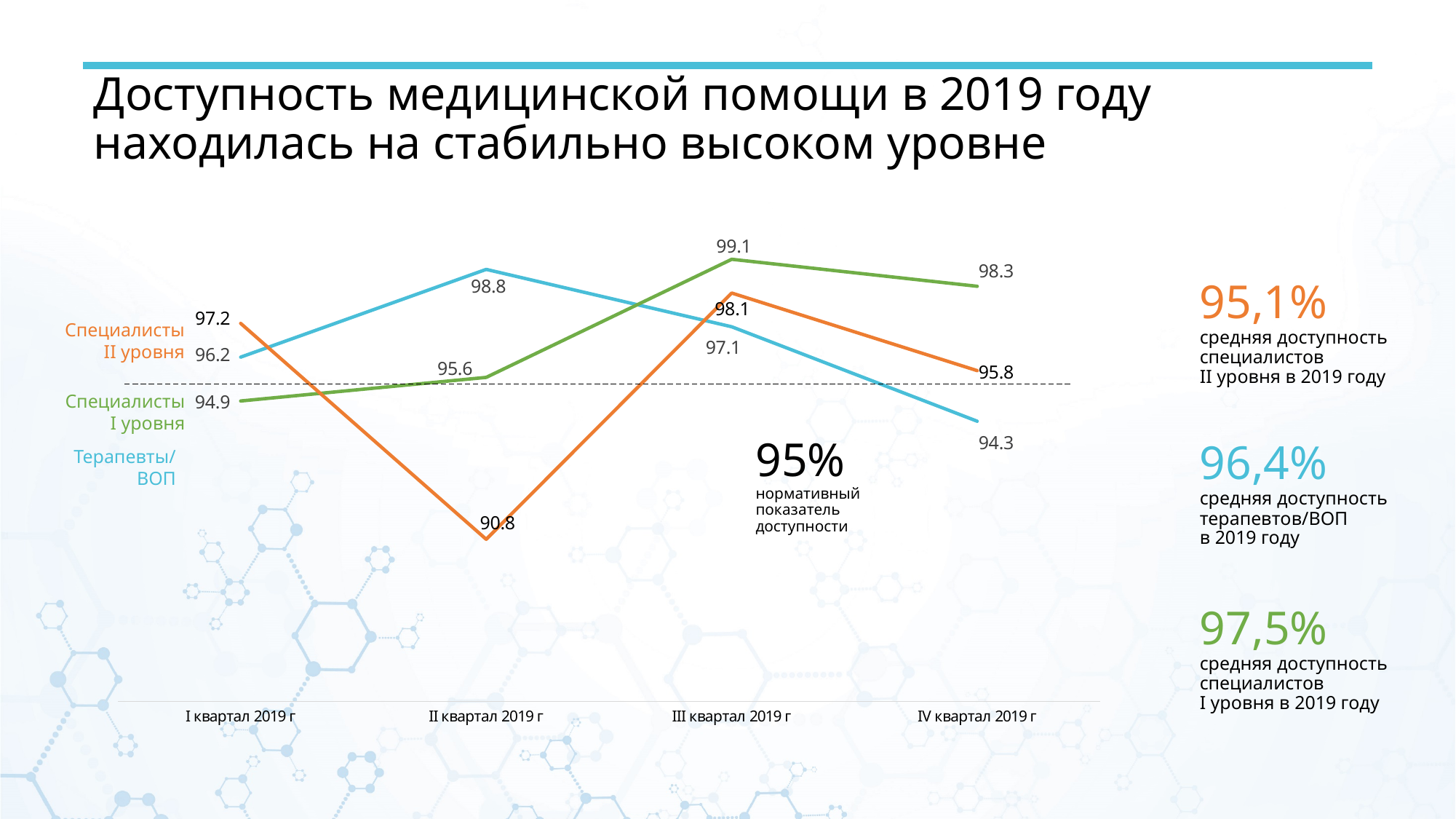
What kind of chart is shown on the slide? line chart In which quarter does Специалисты I уровня reach its highest value? III квартал 2019 г Do the values for Специалисты I уровня rise or fall from I квартал to III квартал 2019 г? rise How many quarters are shown on the x axis of the chart? 4 What is the value for Терапевты/ВОП in II квартал 2019 г? 98.8 In which quarter does Терапевты/ВОП have its lowest value? IV квартал 2019 г Which series has the higher value in I квартал 2019 г: Специалисты II уровня or Специалисты I уровня? Специалисты II уровня What normative accessibility indicator is marked by the dashed line on the chart? 95% What is the value for Специалисты II уровня in II квартал 2019 г? 90.8 What is the difference between the Специалисты II уровня values in III квартал 2019 г and II квартал 2019 г? 7.3 What is the value for Специалисты I уровня in IV квартал 2019 г? 98.3 How many series are plotted on the chart? 3